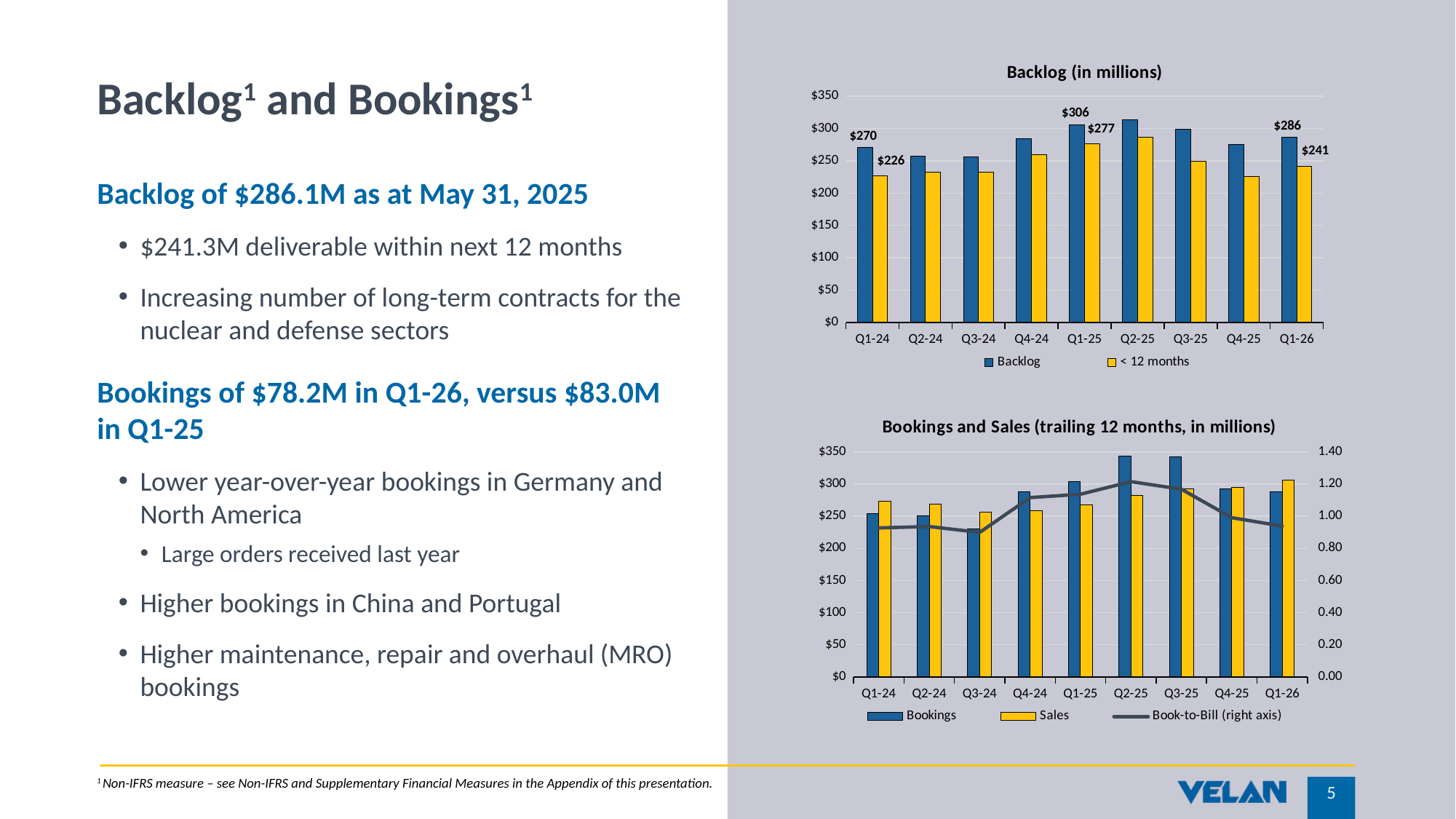
In the Backlog (in millions) chart, what is the < 12 months value for Q1-26? $241 In the Backlog (in millions) chart, what is the Backlog value for Q1-26? $286 In the Backlog (in millions) chart, how much higher is the Backlog in Q1-25 than in Q1-24? $36 How many series does the legend of the Bookings and Sales (trailing 12 months, in millions) chart list? 3 How many series does the legend of the Backlog (in millions) chart list? 2 In the Backlog (in millions) chart, what is the < 12 months value for Q1-25? $277 How many quarters are shown on the x axis of the Backlog (in millions) chart? 9 In the Backlog (in millions) chart, which is larger, the Backlog in Q1-26 or the Backlog in Q1-24? Q1-26 In the Backlog (in millions) chart, what is the difference between the Backlog and the < 12 months value in Q1-26? $45 In the Bookings and Sales (trailing 12 months, in millions) chart, is the Bookings value for Q2-25 greater or less than $300? greater In the Backlog (in millions) chart, what is the Backlog value for Q1-24? $270 In the Bookings and Sales (trailing 12 months, in millions) chart, is the Sales value for Q3-24 greater or less than $300? less